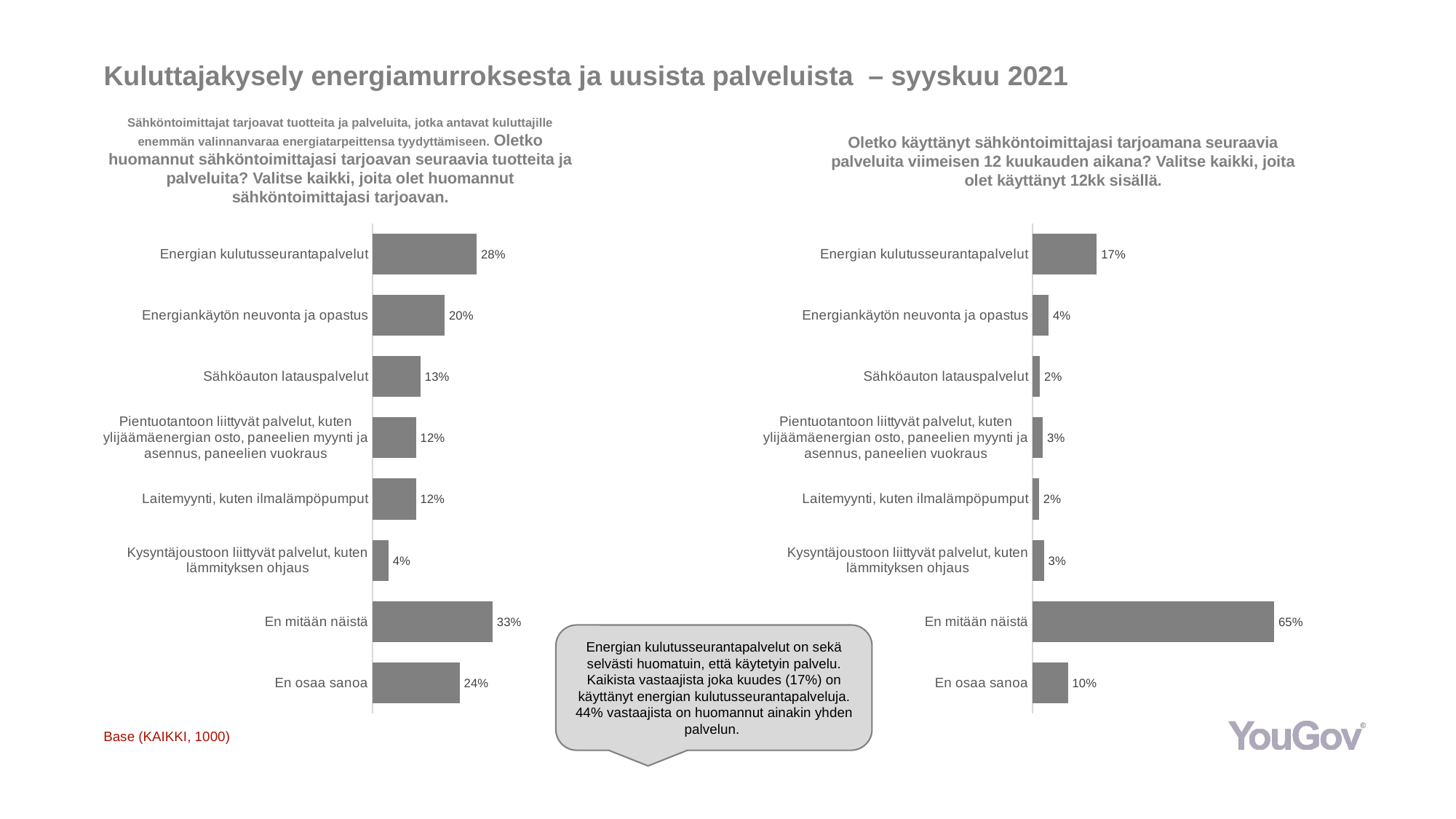
In the left chart (about noticing services offered by the electricity supplier), what is the value for Energian kulutusseurantapalvelut? 28% In the right chart, what is the difference between En mitään näistä and Energian kulutusseurantapalvelut? 48% What is the base (number of respondents) stated on the slide? 1000 How many categories are shown in the right chart? 8 Which is larger: Sähköauton latauspalvelut in the left chart or Sähköauton latauspalvelut in the right chart? Left chart (13%) In the right chart, what is the value for Energiankäytön neuvonta ja opastus? 4% In the left chart, what is the value for En osaa sanoa? 24% In the left chart, what is the difference between Energian kulutusseurantapalvelut and Energiankäytön neuvonta ja opastus? 8% In the left chart, which category has the lowest value? Kysyntäjoustoon liittyvät palvelut, kuten lämmityksen ohjaus What kind of chart is the left chart? Bar chart In the left chart, which category has the highest value? En mitään näistä In the right chart (about services used in the last 12 months), what is the value for En mitään näistä? 65%